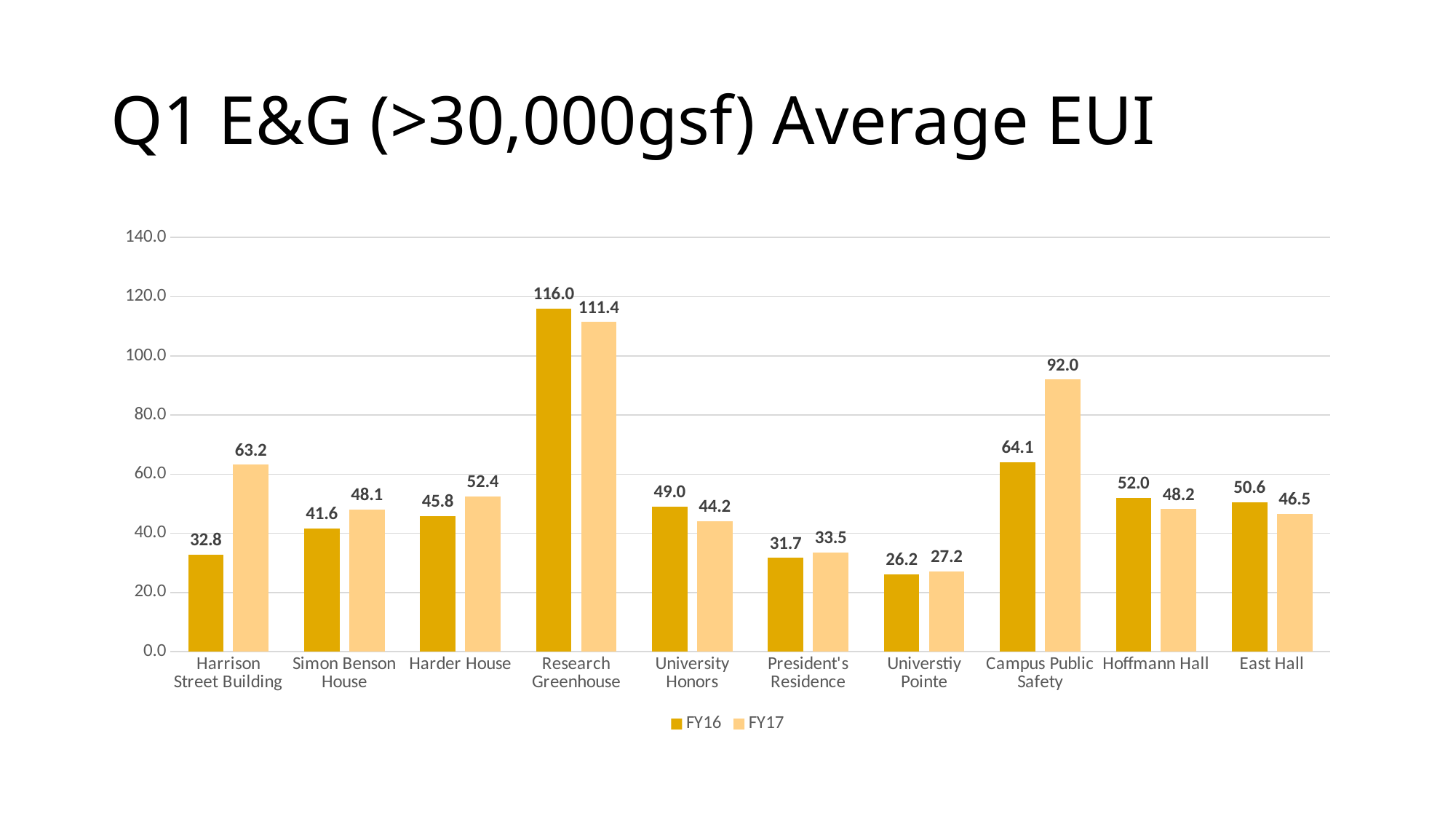
Which is larger for University Honors, the FY16 value or the FY17 value? FY16 How many buildings are shown on the x axis? 10 What kind of chart is shown on the slide? bar chart Which building has the highest FY16 value? Research Greenhouse What is the title of the slide? Q1 E&G (>30,000gsf) Average EUI What is the FY17 value for President's Residence? 33.5 Is the FY16 value for Research Greenhouse greater or less than 100.0? greater What is the difference between the FY17 and FY16 values for Harrison Street Building? 30.4 What is the FY17 value for Campus Public Safety? 92.0 Which building has the lowest FY17 value? Universtiy Pointe How many series does the legend list? 2 What is the FY16 value for Harrison Street Building? 32.8